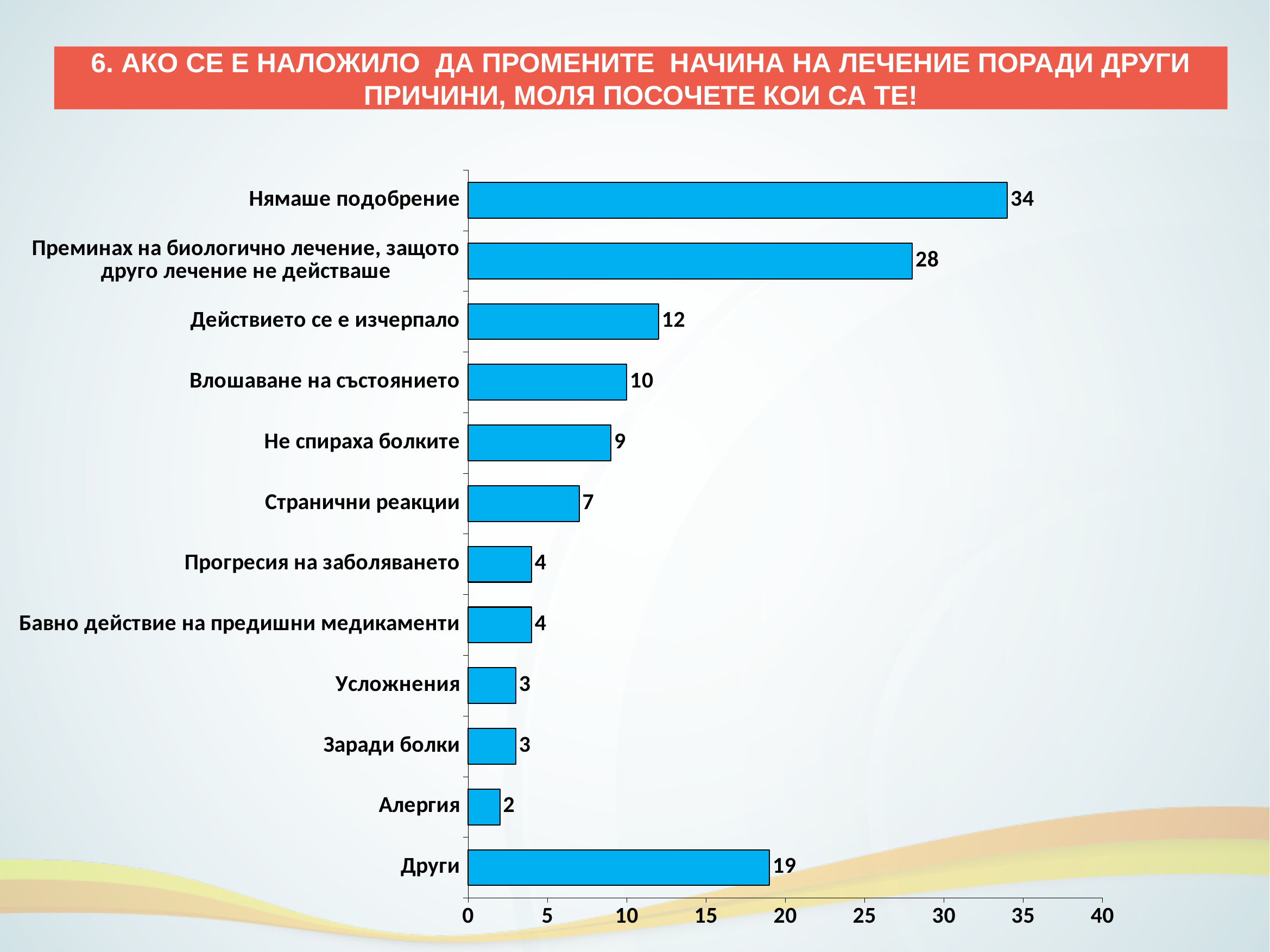
Which category has the highest value? Нямаше подобрение What is the value for "Други"? 19 Which category has the lowest value? Алергия Which is larger: the value for "Влошаване на състоянието" or the value for "Не спираха болките"? Влошаване на състоянието How many categories are shown in the chart? 12 What is the value for "Странични реакции"? 7 What is the difference between the values for "Нямаше подобрение" and "Преминах на биологично лечение, защото друго лечение не действаше"? 6 What is the value for "Нямаше подобрение"? 34 What kind of chart is shown on the slide? Bar chart What is the maximum value shown on the horizontal axis? 40 What is the value for "Действието се е изчерпало"? 12 Is the value for "Преминах на биологично лечение, защото друго лечение не действаше" greater or less than 25? greater